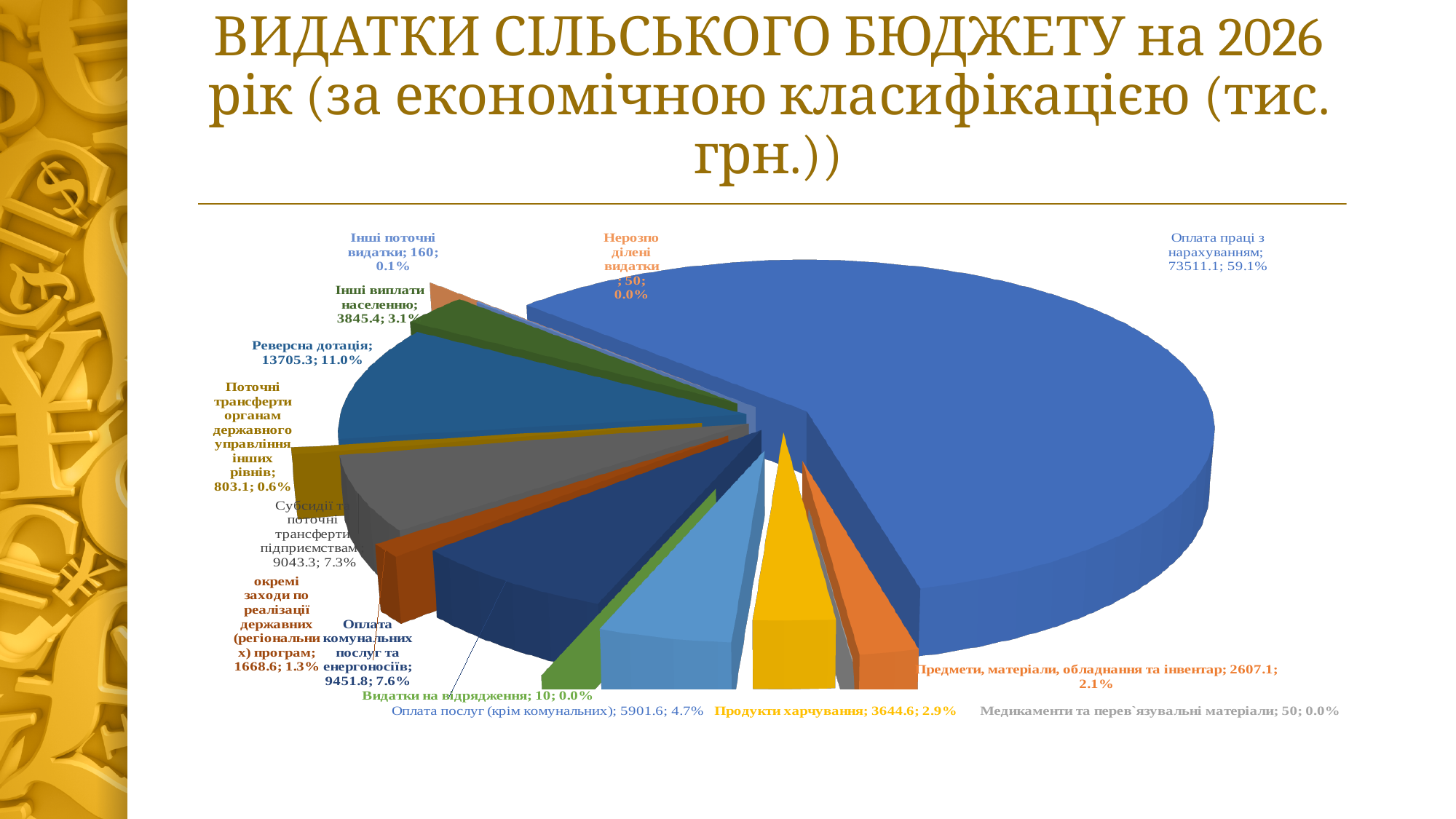
Which category has the smallest value? Видатки на відрядження What is the title of the slide? ВИДАТКИ СІЛЬСЬКОГО БЮДЖЕТУ на 2026 рік (за економічною класифікацією (тис. грн.)) What is the value for Продукти харчування? 3644.6 What is the difference between the values for Реверсна дотація and Субсидії та поточні трансферти підприємствам? 4662 Which category has the largest value? Оплата праці з нарахуванням What share of the pie does Оплата комунальних послуг та енергоносіїв represent? 7.6% What share of the pie does Оплата праці з нарахуванням represent? 59.1% What is the value for Оплата праці з нарахуванням? 73511.1 What kind of chart is shown on the slide? Pie chart What is the value for Реверсна дотація? 13705.3 Which is larger: Субсидії та поточні трансферти підприємствам or Оплата комунальних послуг та енергоносіїв? Оплата комунальних послуг та енергоносіїв How many categories does the pie chart have? 14